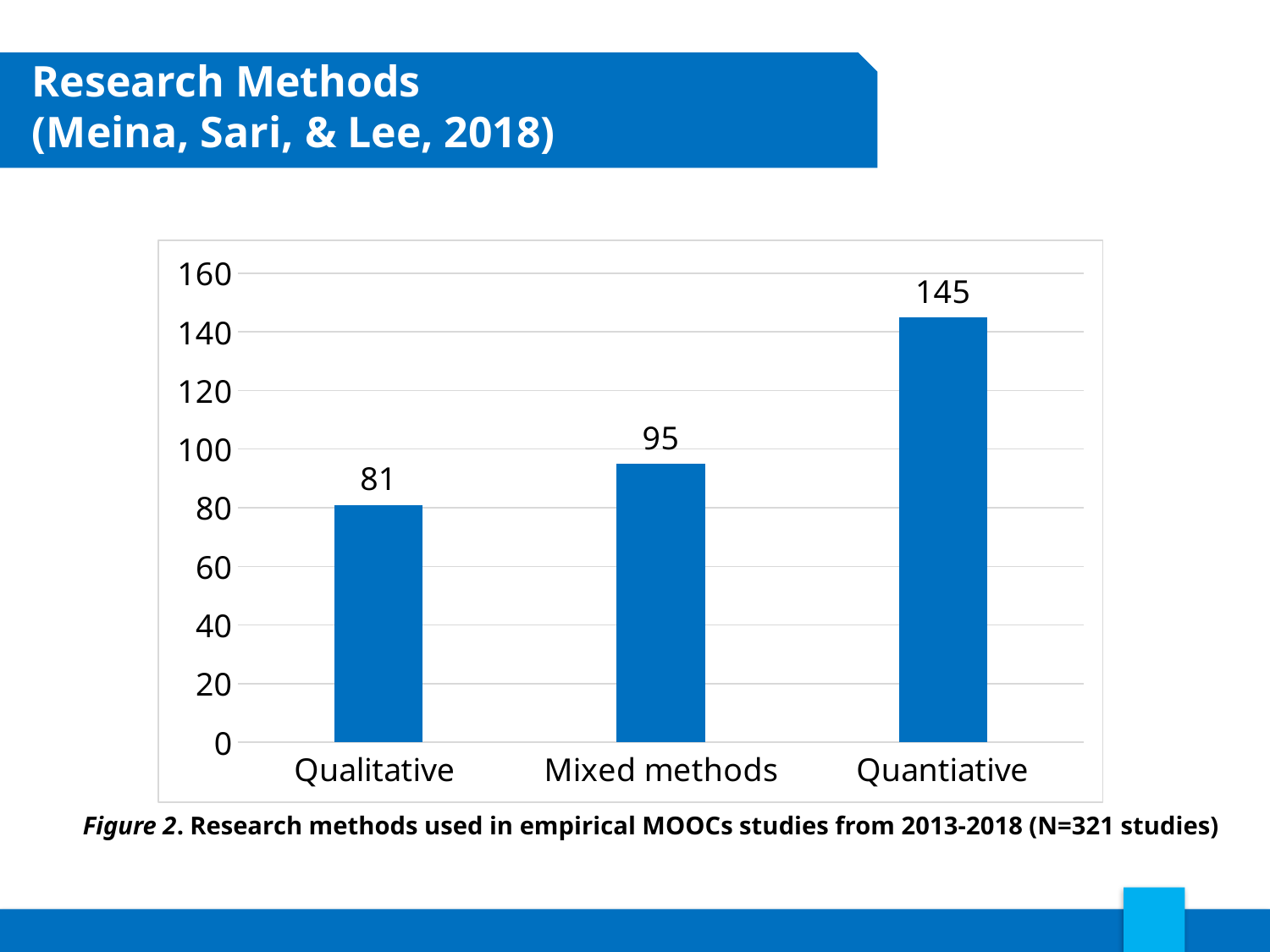
What is the difference between the values for Mixed methods and Qualitative? 14 Which is larger, the value for Mixed methods or the value for Qualitative? Mixed methods What is the value for Qualitative? 81 Which research method has the lowest value? Qualitative What is the difference between the values for Quantiative and Qualitative? 64 What is the value for Mixed methods? 95 What kind of chart is shown on the slide? bar chart What is the value for Quantiative? 145 Which research method has the highest value? Quantiative How many categories are shown on the x axis? 3 Do the values rise or fall from left to right along the x axis? rise Is the value for Quantiative greater or less than 140? greater